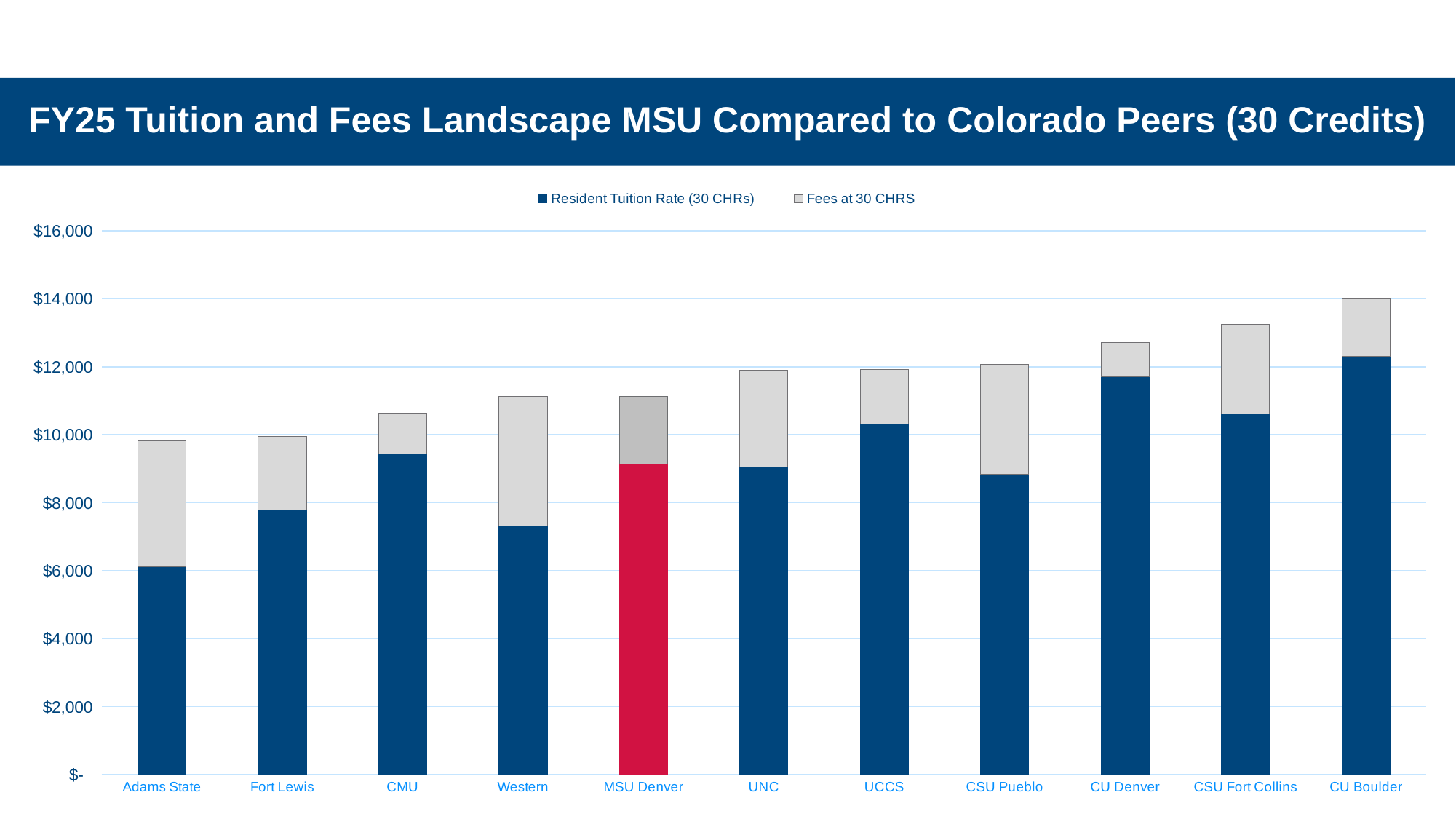
Which institution has the highest total tuition and fees bar? CU Boulder Which is larger, the Resident Tuition Rate (30 CHRs) for CMU or for Western? CMU Is the total tuition and fees bar for CU Boulder greater or less than $12,000? greater Do the total tuition and fees bars generally rise or fall from left to right across the x axis? rise Is the Resident Tuition Rate (30 CHRs) for Adams State greater or less than $8,000? less Is the total tuition and fees bar for MSU Denver greater or less than $10,000? greater How many series does the chart's legend list? 2 What kind of chart is shown on the slide? Stacked bar chart Which institution's tuition segment is highlighted in red rather than dark blue? MSU Denver Which institution has the highest Resident Tuition Rate (30 CHRs) segment? CU Boulder Which institution has the lowest Resident Tuition Rate (30 CHRs) segment? Adams State How many institutions are shown on the x axis of the chart? 11